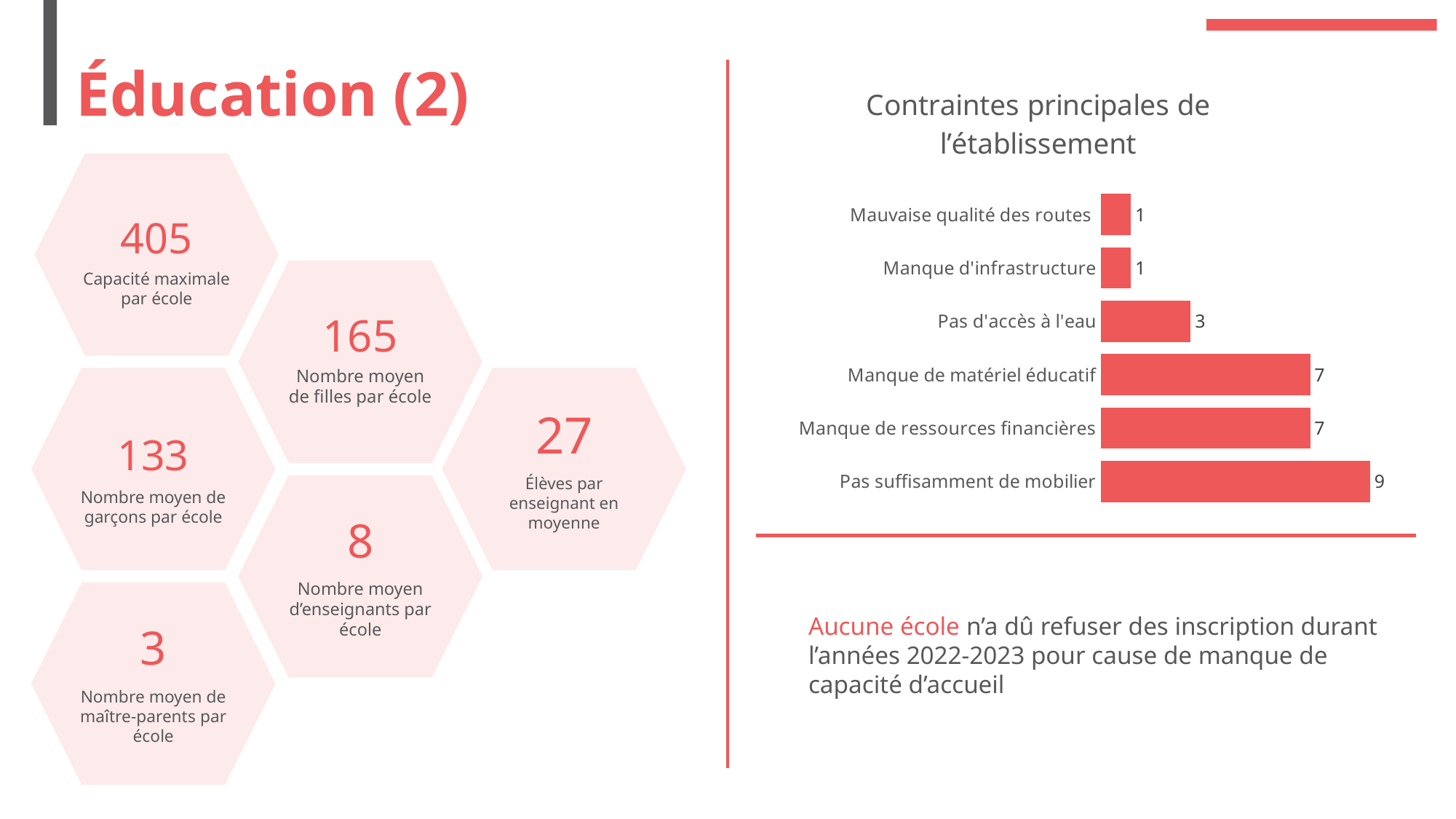
What is the difference between "Pas suffisamment de mobilier" and "Manque de ressources financières"? 2 Which category has the highest value? Pas suffisamment de mobilier What is the difference between "Manque de matériel éducatif" and "Pas d'accès à l'eau"? 4 How many categories does the chart show? 6 What is the value for "Pas suffisamment de mobilier"? 9 Which is larger, "Pas d'accès à l'eau" or "Manque d'infrastructure"? Pas d'accès à l'eau What is the value for "Manque de matériel éducatif"? 7 What kind of chart is shown? Bar chart What is the value for "Mauvaise qualité des routes"? 1 What is the title of the chart? Contraintes principales de l'établissement What is the value for "Pas d'accès à l'eau"? 3 How many categories have a value of 7? 2